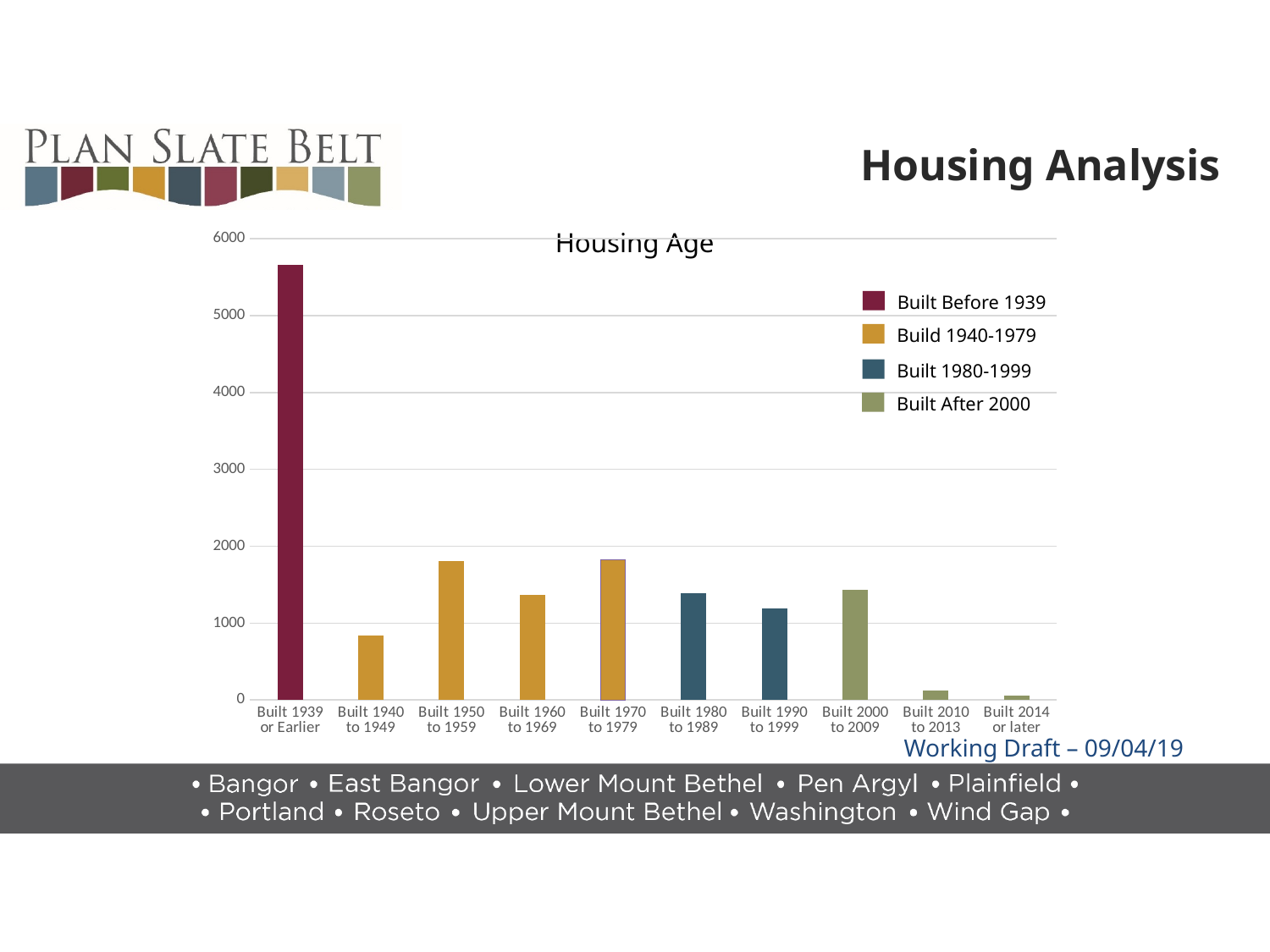
Which legend entry is shown in dark red in the Housing Age chart? Built Before 1939 How many entries does the legend of the Housing Age chart list? 4 Is the value for Built 1939 or Earlier greater or less than 5000? greater Is the value for Built 2000 to 2009 greater or less than 1000? greater Is the value for Built 1940 to 1949 greater or less than 1000? less Which category has the highest value in the Housing Age chart? Built 1939 or Earlier How many categories are shown along the x axis of the Housing Age chart? 10 What type of chart is shown on the slide? Bar chart What is the title of the chart? Housing Age Which is larger, the value for Built 1940 to 1949 or the value for Built 1990 to 1999? Built 1990 to 1999 Which category has the lowest value in the Housing Age chart? Built 2014 or later